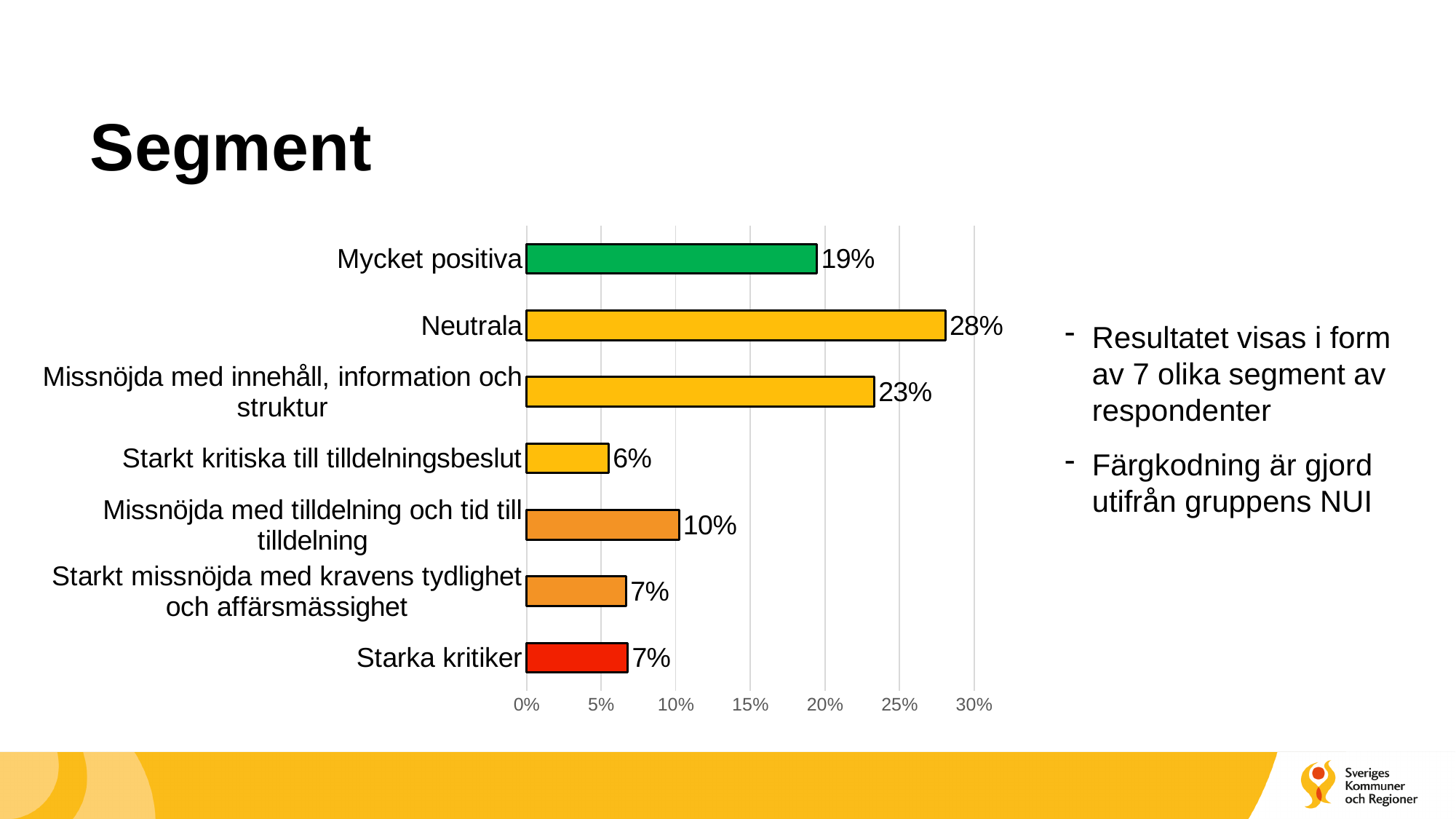
What is the value for Starkt kritiska till tilldelningsbeslut? 6% Which category has the highest value? Neutrala What colour is the bar for Starka kritiker? Red Which is larger, the value for Mycket positiva or the value for Missnöjda med innehåll, information och struktur? Missnöjda med innehåll, information och struktur What is the value for Mycket positiva? 19% What kind of chart is shown on the slide? Bar chart What is the value for Missnöjda med innehåll, information och struktur? 23% What is the value for Neutrala? 28% What is the value for Missnöjda med tilldelning och tid till tilldelning? 10% What is the difference between the values for Neutrala and Mycket positiva? 9% Which category has the lowest value? Starkt kritiska till tilldelningsbeslut How many categories are shown in the chart? 7